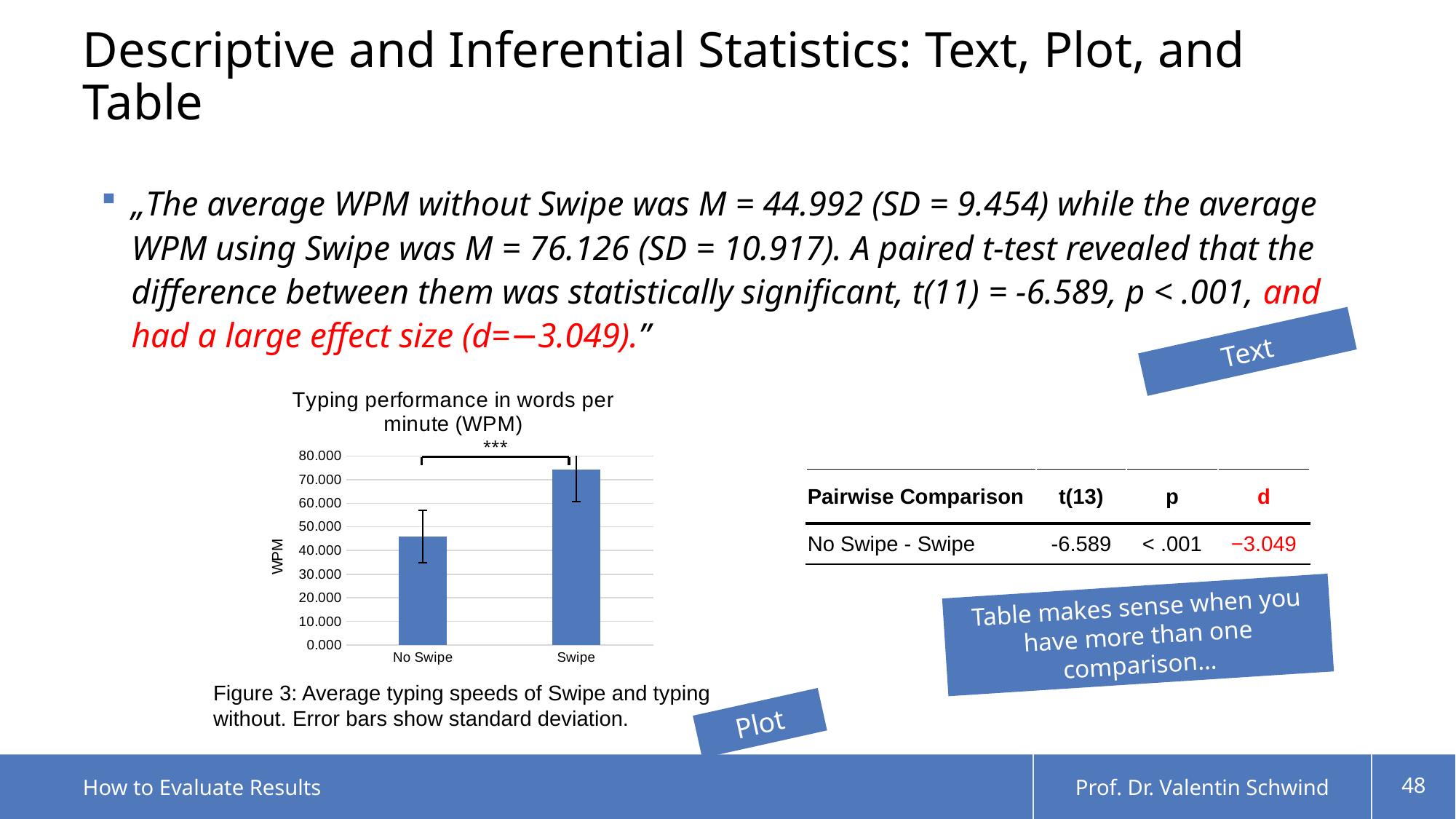
Do the bar values rise or fall from No Swipe to Swipe along the x axis? rise Which category has the lowest bar in the chart? No Swipe Is the value for Swipe greater or less than 70.000? greater Which bar is taller, No Swipe or Swipe? Swipe What is the label on the y axis of the chart? WPM What kind of chart is shown on the slide? bar chart Which category has the highest bar in the chart? Swipe How many categories are plotted on the x axis of the chart? 2 What is the title of the chart? Typing performance in words per minute (WPM) Is the value for No Swipe greater or less than 40.000? greater Is the value for Swipe greater or less than 80.000? less